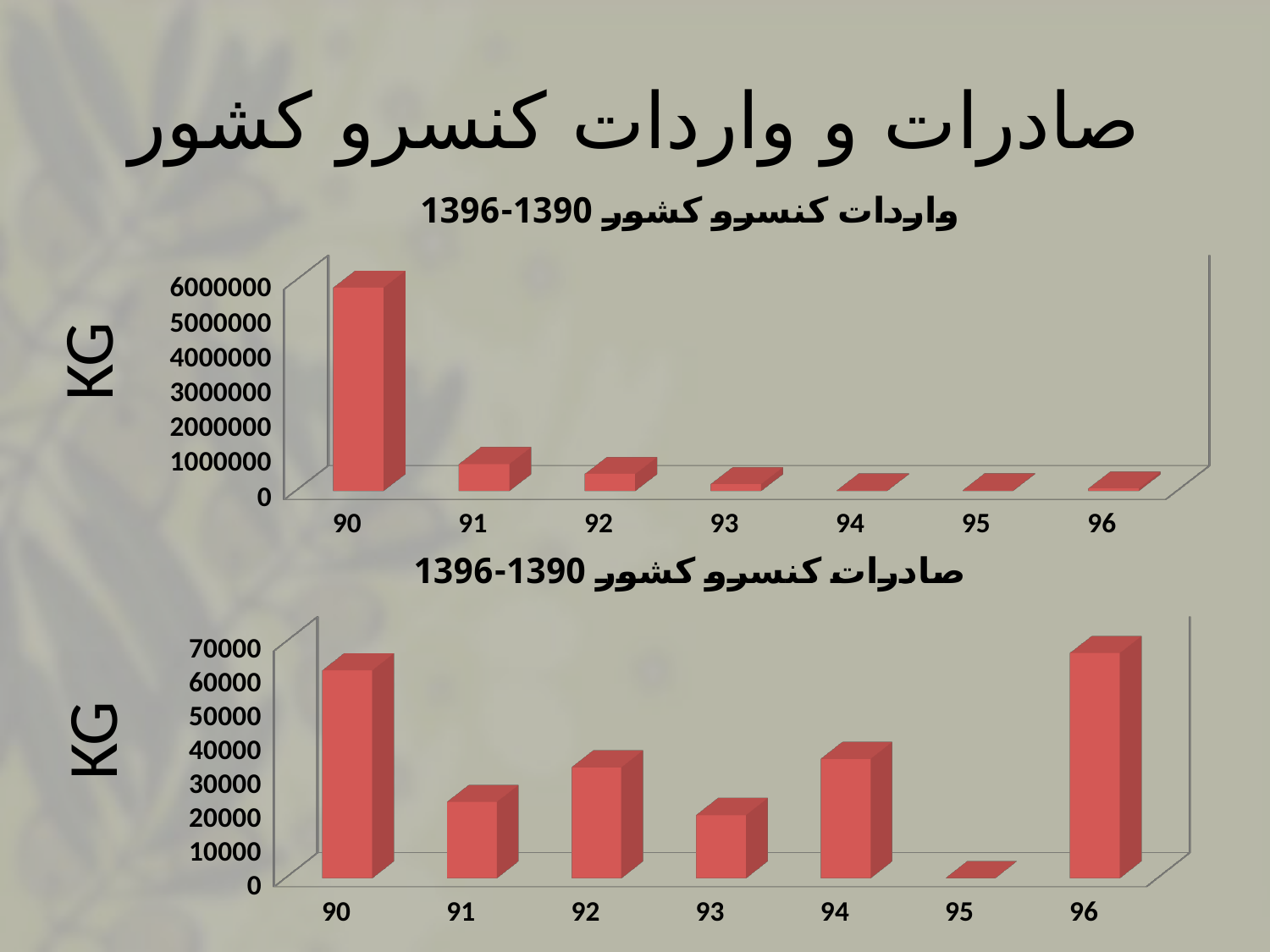
In the top chart (واردات کنسرو کشور 1396-1390), do the values generally rise or fall from 90 to 96? fall How many years are shown on the x axis of the top chart (واردات کنسرو کشور 1396-1390)? 7 In the top chart (واردات کنسرو کشور 1396-1390), which year has the highest value? 90 In the bottom chart (صادرات کنسرو کشور 1396-1390), is the value for 93 greater or less than 30000? less In the bottom chart (صادرات کنسرو کشور 1396-1390), is the value for 90 greater or less than 50000? greater In the top chart (واردات کنسرو کشور 1396-1390), is the value for 90 greater or less than 5000000? greater What unit is shown on the y axis label of the bottom chart (صادرات کنسرو کشور 1396-1390)? KG In the bottom chart (صادرات کنسرو کشور 1396-1390), which is larger, the value for 90 or the value for 91? 90 What kind of chart is the top chart (واردات کنسرو کشور 1396-1390)? bar chart In the bottom chart (صادرات کنسرو کشور 1396-1390), which year has the lowest value? 95 In the bottom chart (صادرات کنسرو کشور 1396-1390), which year has the highest value? 96